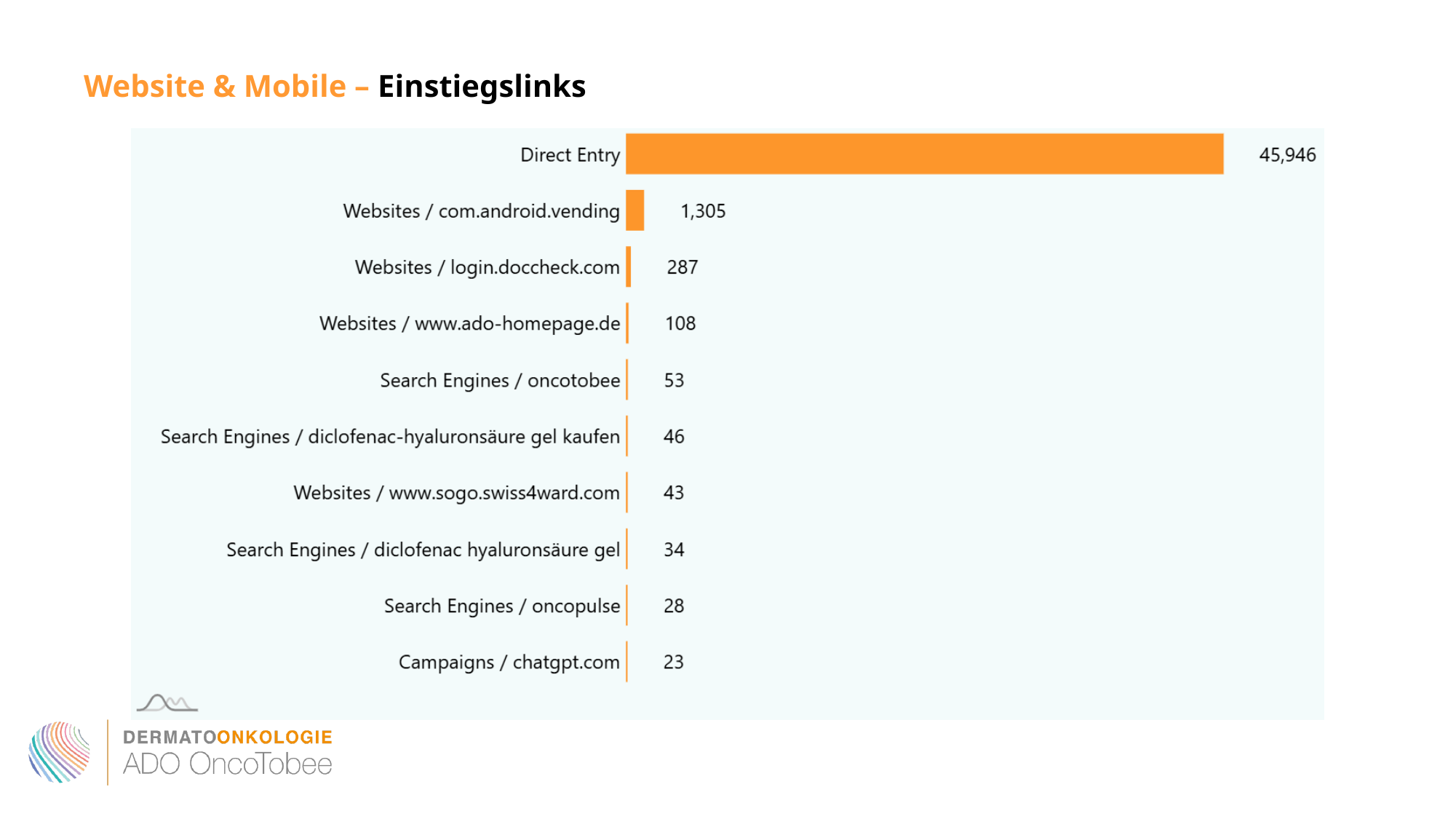
What is the value for Search Engines / oncotobee? 53 What colour are the bars in the chart? Orange What is the difference between the values for Websites / com.android.vending and Websites / login.doccheck.com? 1,018 What is the value for Campaigns / chatgpt.com? 23 What is the value for Websites / com.android.vending? 1,305 Which is larger, the value for Search Engines / oncopulse or the value for Search Engines / diclofenac hyaluronsäure gel? Search Engines / diclofenac hyaluronsäure gel What is the value for Direct Entry? 45,946 Which category has the lowest value? Campaigns / chatgpt.com What is the value for Websites / login.doccheck.com? 287 How many categories are shown in the chart? 10 What kind of chart is shown on the slide? Bar chart Which category has the highest value? Direct Entry